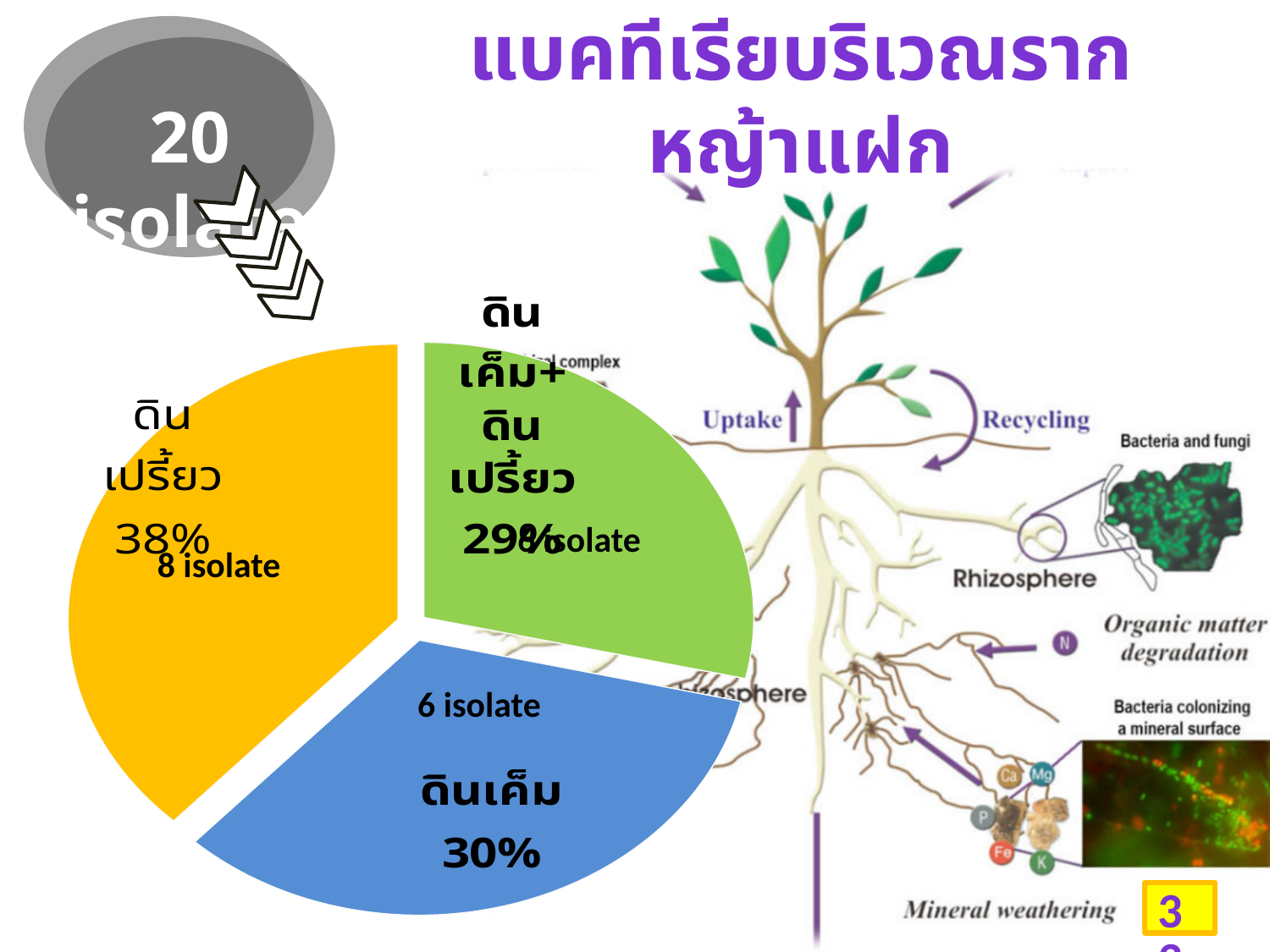
How many isolates are labelled on the ดินเค็ม slice? 6 isolate Which slice of the pie chart has the largest share? ดินเปรี้ยว How many isolates are labelled on the ดินเปรี้ยว slice? 8 isolate Which slice of the pie chart has the smallest share? ดินเค็ม+ดินเปรี้ยว What percentage does the pie chart show for ดินเค็ม? 30% What percentage does the pie chart show for ดินเค็ม+ดินเปรี้ยว? 29% How many slices does the pie chart have? 3 What percentage does the pie chart show for ดินเปรี้ยว? 38% What colour is the ดินเปรี้ยว slice of the pie chart? yellow Which has a larger share in the pie chart, ดินเปรี้ยว or ดินเค็ม? ดินเปรี้ยว By how many percentage points does the ดินเปรี้ยว share exceed the ดินเค็ม share? 8 What kind of chart is shown on the left of the slide? pie chart